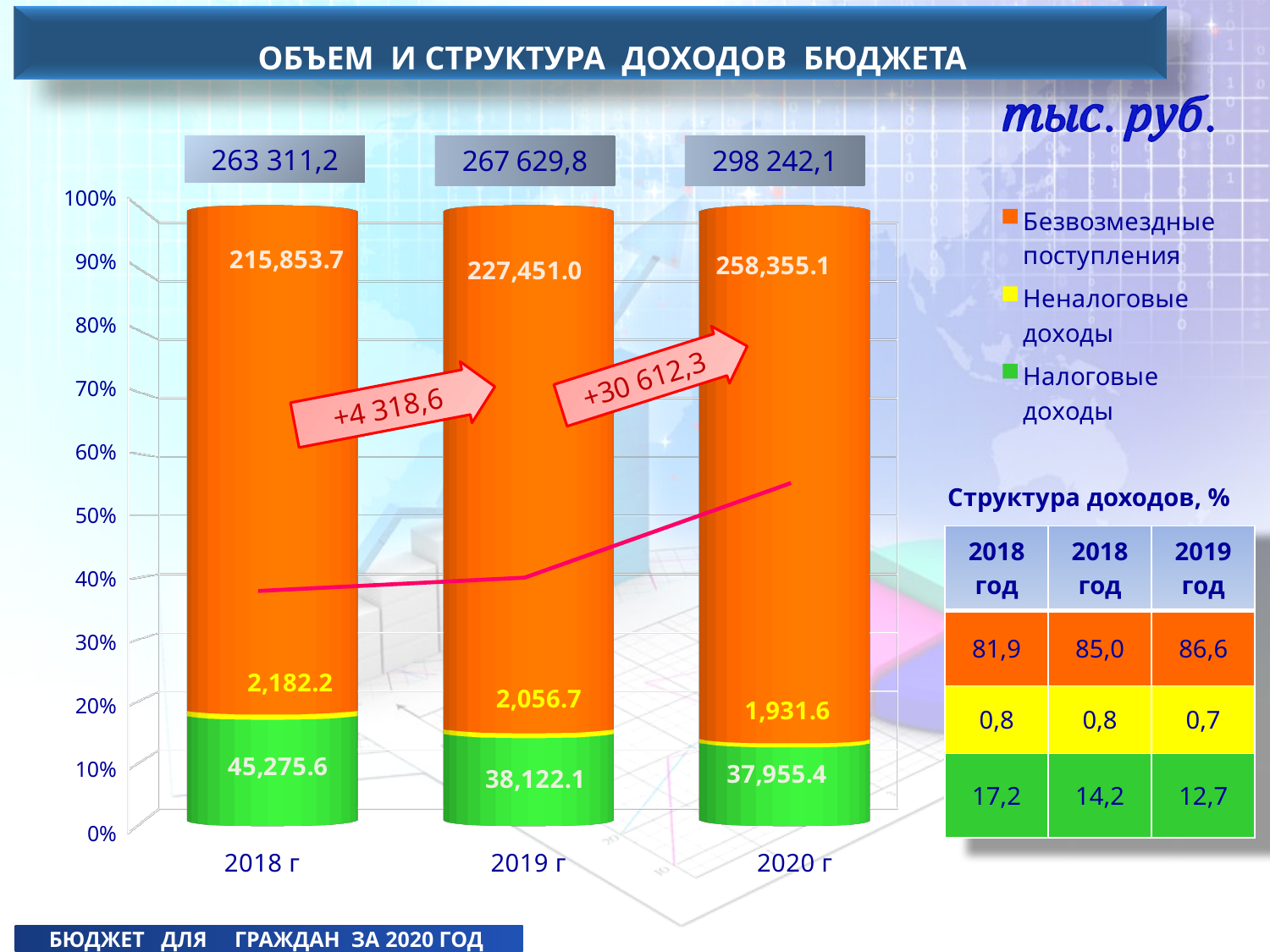
In which year is Безвозмездные поступления highest? 2020 г What is the value of Налоговые доходы for 2019 г? 38,122.1 How many years are shown on the x axis? 3 Which is larger: Неналоговые доходы in 2018 г or in 2019 г? 2018 г In which year is Налоговые доходы lowest? 2020 г Do the values of Неналоговые доходы rise or fall from 2018 г to 2020 г? fall What is the value of Неналоговые доходы for 2020 г? 1,931.6 What is the difference between Налоговые доходы in 2018 г and 2019 г? 7,153.5 What total is printed above the bar for 2020 г? 298 242,1 What kind of chart is shown? stacked bar chart How many series does the legend list? 3 What is the value of Безвозмездные поступления for 2018 г? 215,853.7